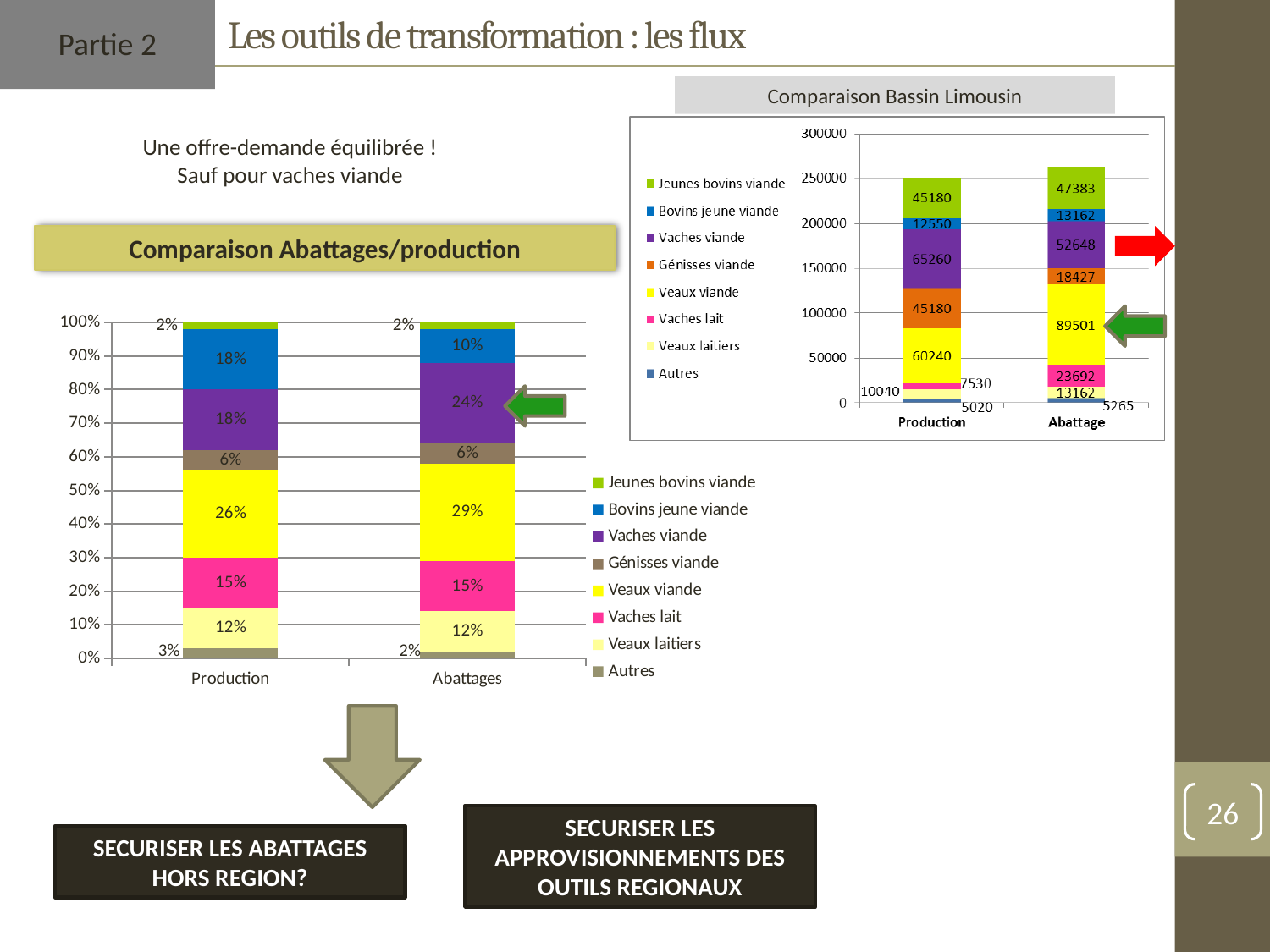
In the 'Comparaison Abattages/production' chart, what is the share of Veaux viande in the Abattages bar? 29% In the 'Comparaison Bassin Limousin' chart, how many categories are shown on the x axis? 2 What kind of chart is 'Comparaison Abattages/production'? Stacked bar chart In the 'Comparaison Bassin Limousin' chart, what is the difference between Vaches lait for Abattage and for Production? 16162 In the 'Comparaison Bassin Limousin' chart, which segment is the largest in the Abattage bar? Veaux viande In the 'Comparaison Bassin Limousin' chart, what is the value of Veaux viande for Abattage? 89501 In the 'Comparaison Bassin Limousin' chart, what is the value of Vaches viande for Production? 65260 In the 'Comparaison Abattages/production' chart, what is the difference between the Vaches viande share in Abattages and in Production? 6 percentage points In the 'Comparaison Abattages/production' chart, which bar has the larger share of Bovins jeune viande, Production or Abattages? Production In the 'Comparaison Bassin Limousin' chart, what is the total of the Production bar? 251000 In the 'Comparaison Abattages/production' chart, how many series does the legend list? 8 In the 'Comparaison Abattages/production' chart, what is the share of Vaches viande in the Production bar? 18%